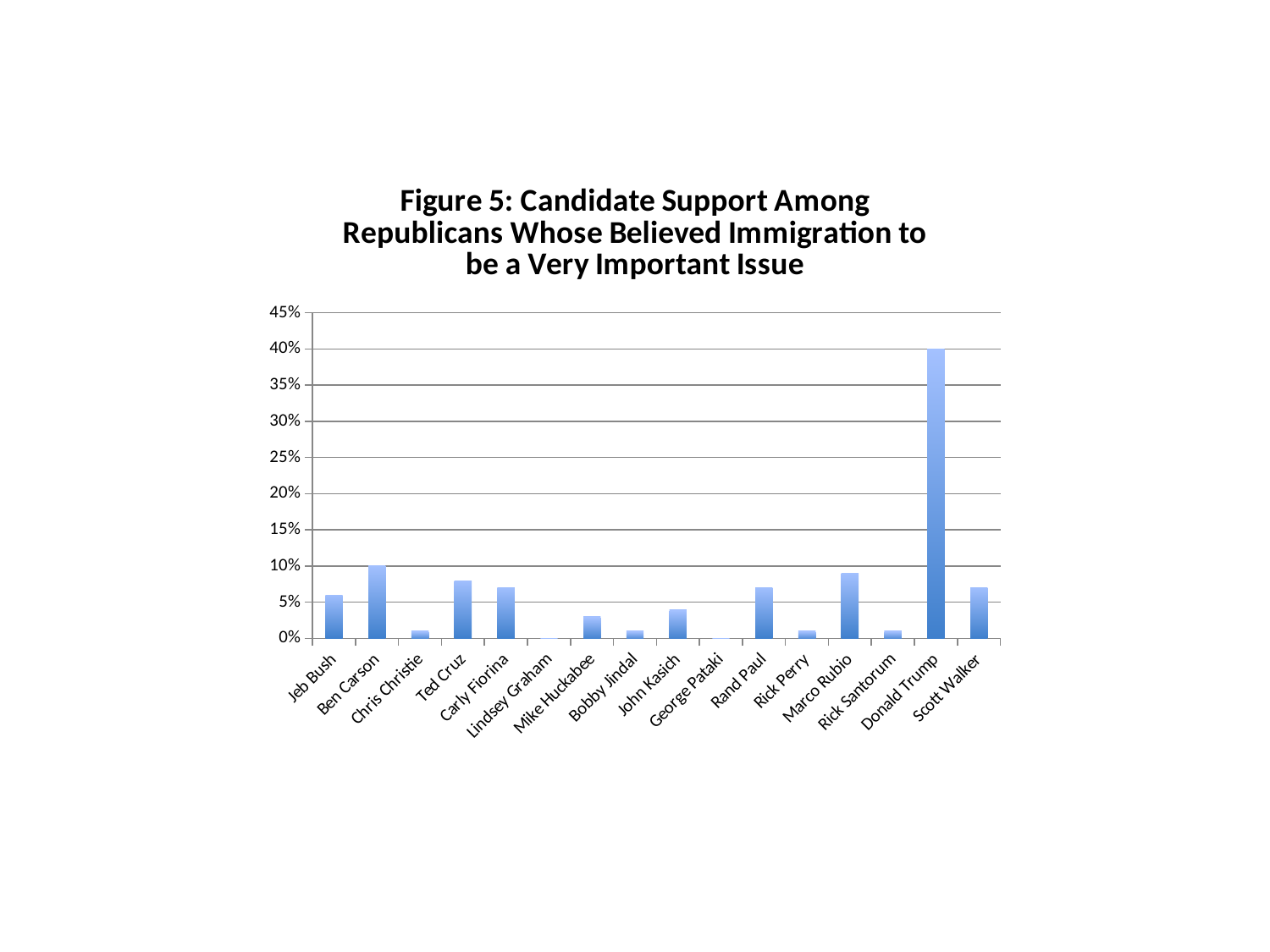
Which has a larger value, Ben Carson or Jeb Bush? Ben Carson What is the figure number given in the chart title? Figure 5 Is the value for Chris Christie greater or less than 5%? less What type of chart is shown on the slide? bar chart Is the value for Marco Rubio greater or less than 5%? greater What is the difference between Donald Trump's and Ben Carson's support? 30% Which has a larger value, Ted Cruz or Mike Huckabee? Ted Cruz Is the value for Jeb Bush greater or less than 10%? less Which candidate has the highest support in the chart? Donald Trump What is the support value for Ben Carson? 10% What is the support value for Donald Trump? 40% How many candidates are shown on the x axis? 16